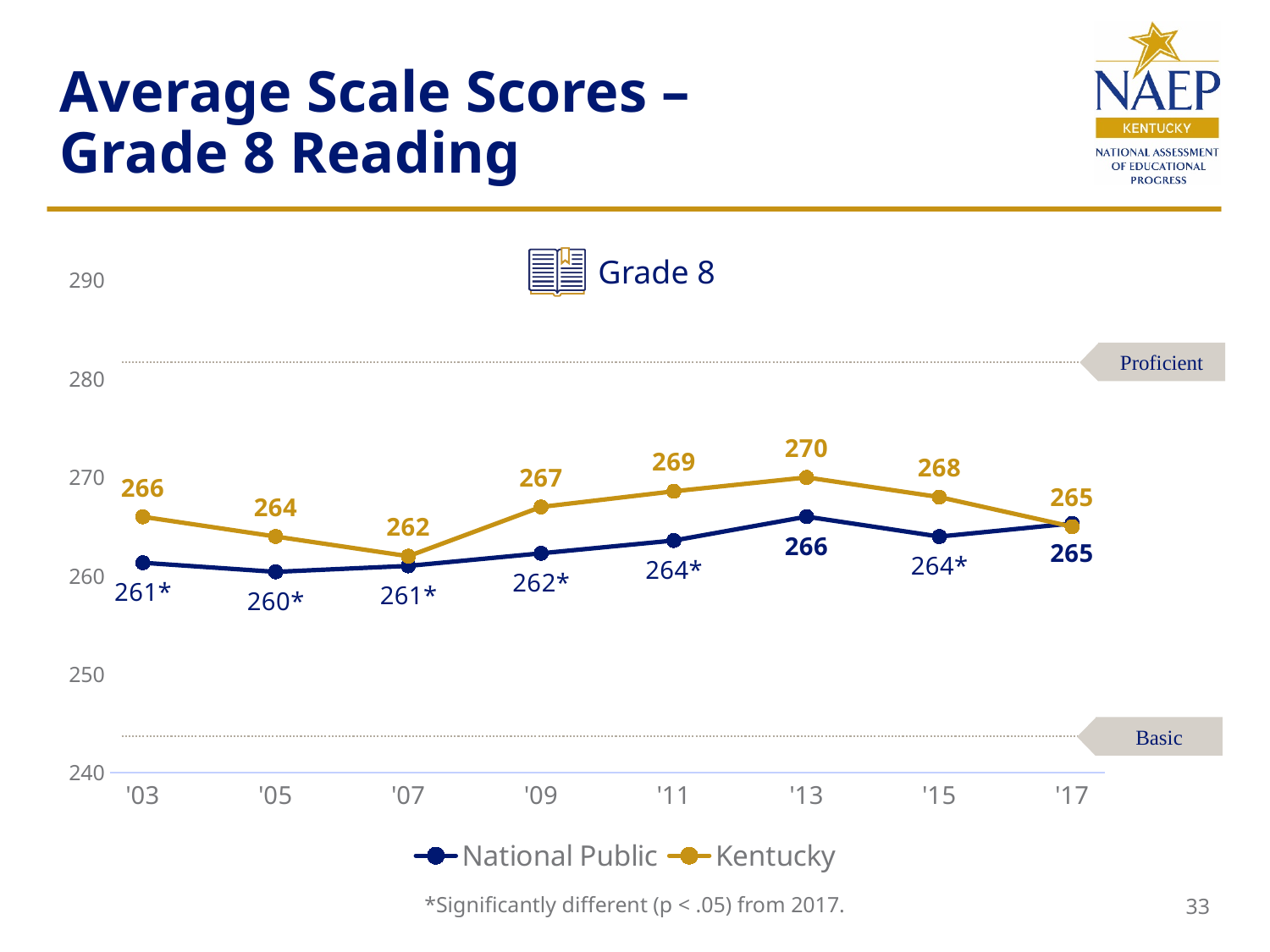
Is the Kentucky score for '13 greater or less than 280? less What is the Kentucky average scale score for '13? 270 What kind of chart is shown on the slide? line chart In which year is the Kentucky score lowest? '07 Which series has the higher score in '09, National Public or Kentucky? Kentucky In which year is the Kentucky score highest? '13 What is the difference between the Kentucky and National Public scores in '13? 4 How many series does the legend list? 2 How many years are shown on the x axis? 8 What is the National Public average scale score for '05? 260* Does the Kentucky score rise or fall from '07 to '13? rise What is the Kentucky average scale score for '17? 265